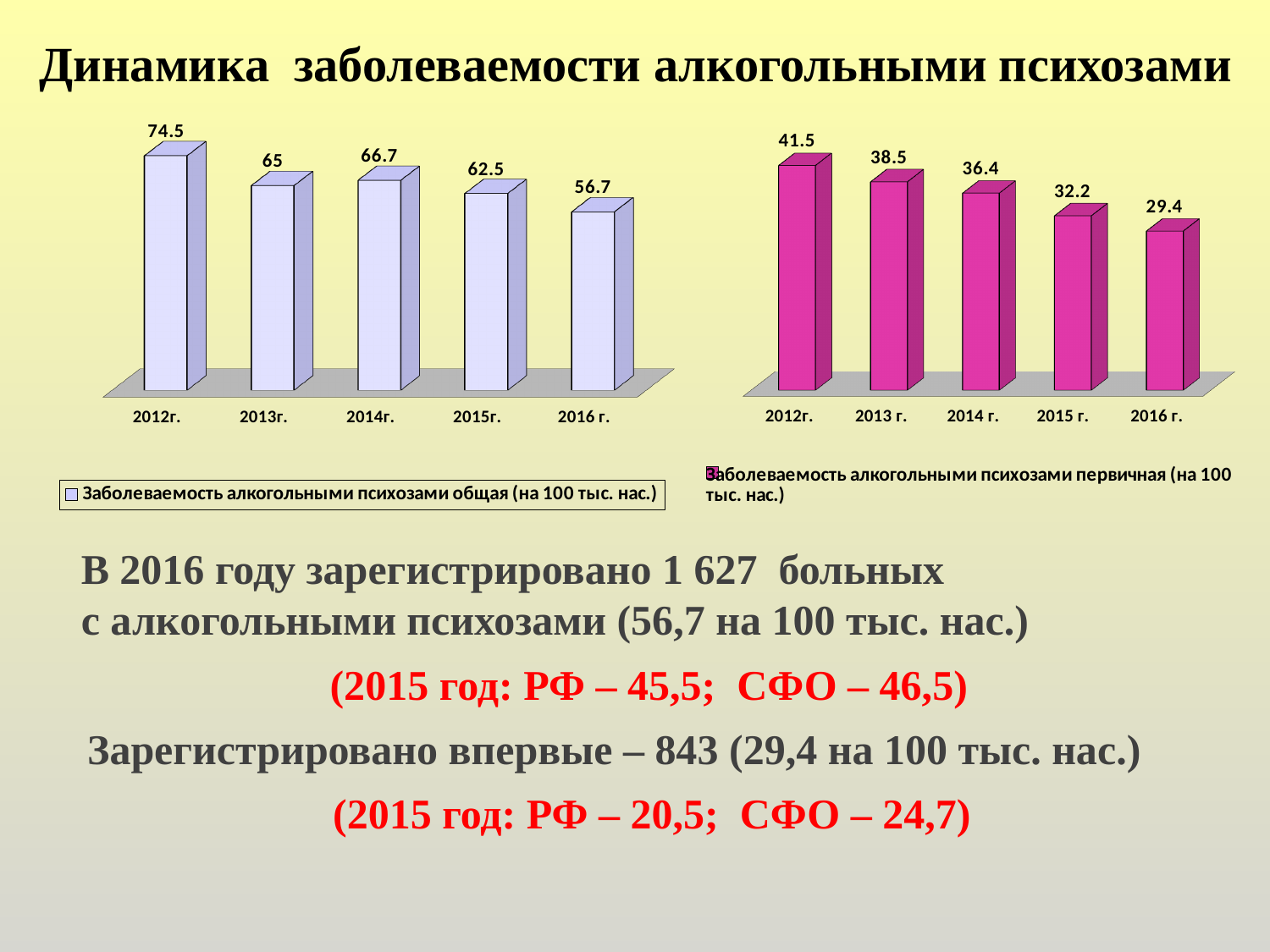
How many bars are shown in the right chart? 5 In the right chart, do the values rise or fall from 2012г. to 2016 г.? fall In the left chart, what is the value for 2015г.? 62.5 In the right chart, which year has the highest value? 2012г. In the left chart, which year has the lowest value? 2016 г. What type of chart is the left chart? bar chart In the left chart, what is the difference between the values for 2012г. and 2016 г.? 17.8 In the left chart, which is larger: the value for 2013г. or the value for 2014г.? 2014г. What colour are the bars in the right chart? magenta (pink) In the left chart (Заболеваемость алкогольными психозами общая), what is the value for 2012г.? 74.5 In the right chart, what is the difference between the values for 2013 г. and 2014 г.? 2.1 In the right chart (Заболеваемость алкогольными психозами первичная), what is the value for 2016 г.? 29.4